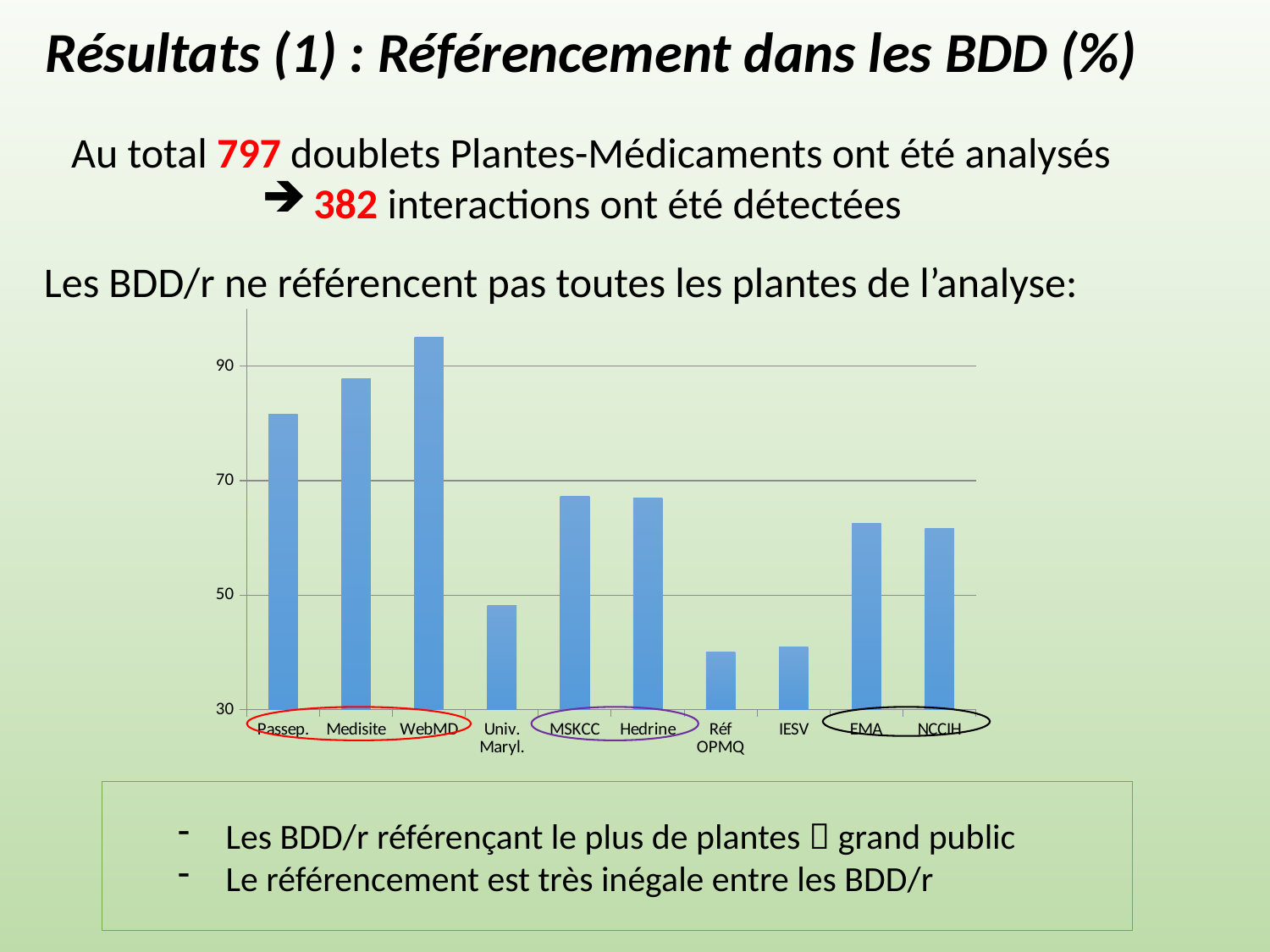
How many databases (categories) are shown on the x axis of the chart? 10 What kind of chart is shown on the slide? bar chart What is the lowest value shown on the vertical axis of the chart? 30 Is the value for EMA greater or less than 50? greater Is the value for Passep. greater or less than 70? greater Which has a larger value, WebMD or Hedrine? WebMD Is the value for Univ. Maryl. greater or less than 50? less Which has a larger value, Medisite or Passep.? Medisite Which database has the highest value in the chart? WebMD